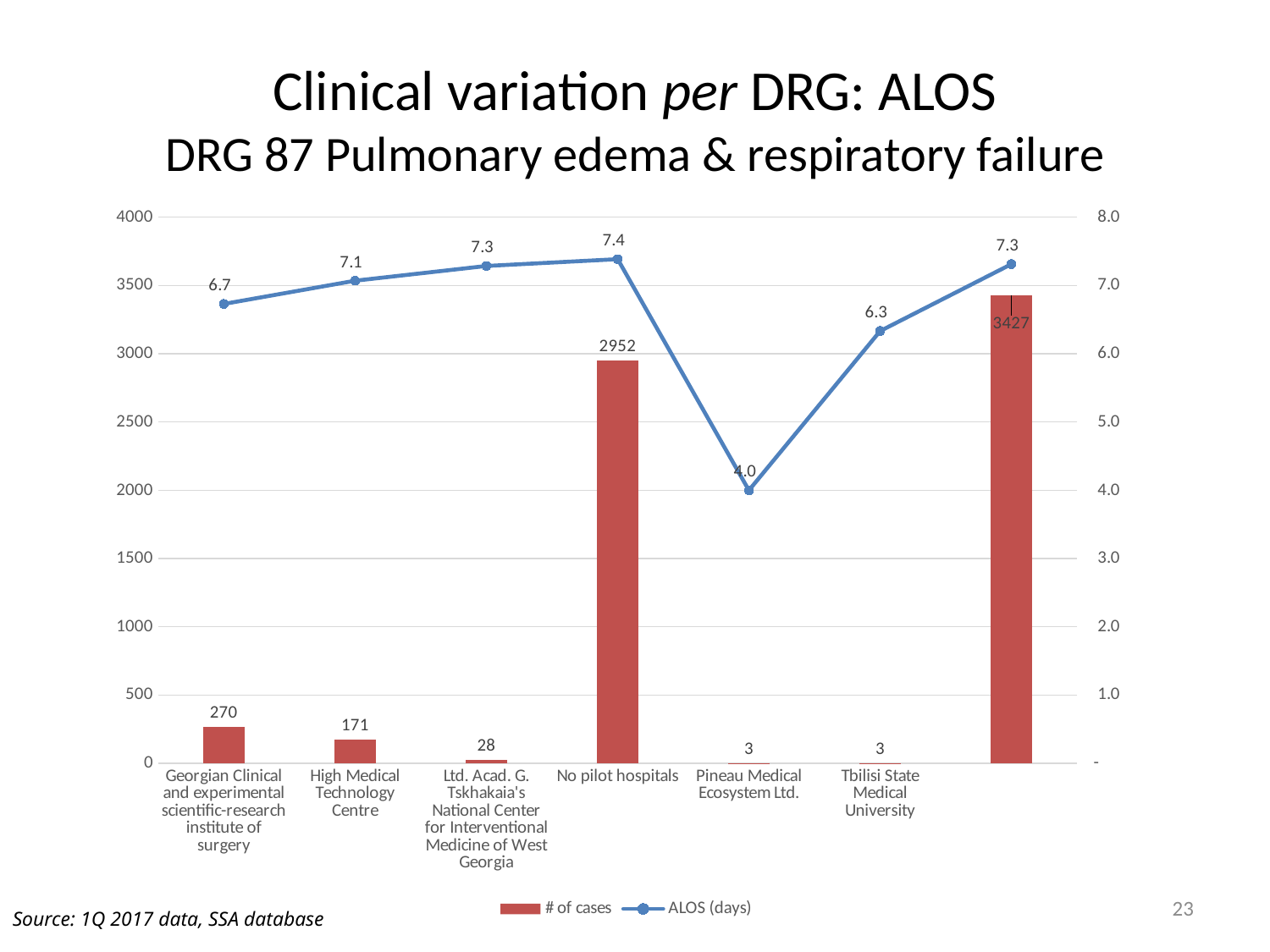
What is the ALOS (days) for Tbilisi State Medical University? 6.3 How many series does the legend list? 2 How many cases are shown for No pilot hospitals? 2952 What is the difference in ALOS (days) between No pilot hospitals and Pineau Medical Ecosystem Ltd.? 3.4 Is the number of cases for No pilot hospitals greater or less than 2500? greater Which has more cases, Georgian Clinical and experimental scientific-research institute of surgery or High Medical Technology Centre? Georgian Clinical and experimental scientific-research institute of surgery Which category has the lowest ALOS (days)? Pineau Medical Ecosystem Ltd. What kind of chart is shown on the slide? Combination bar and line chart Which category has the highest ALOS (days)? No pilot hospitals What is the ALOS (days) for Pineau Medical Ecosystem Ltd.? 4.0 What is the difference in number of cases between No pilot hospitals and Georgian Clinical and experimental scientific-research institute of surgery? 2682 How many cases are shown for High Medical Technology Centre? 171